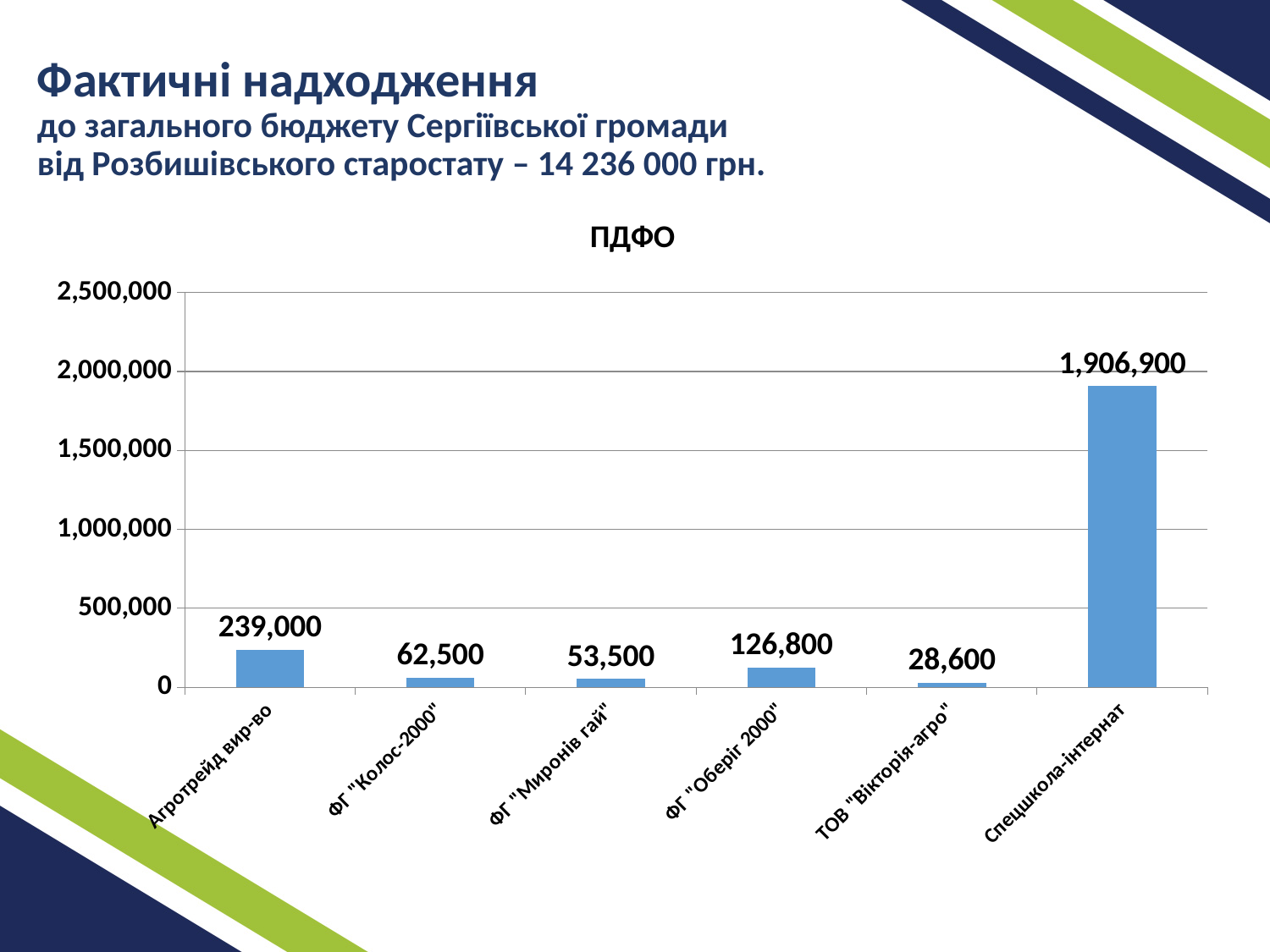
How many categories are shown on the chart? 6 Is the value for Спецшкола-інтернат greater or less than 1,500,000? greater What kind of chart is shown on the slide? bar chart What is the value for Спецшкола-інтернат? 1,906,900 Which is larger, the value for Агротрейд вир-во or the value for ФГ "Оберіг 2000"? Агротрейд вир-во What is the value for ТОВ "Вікторія-агро"? 28,600 Which category has the highest value? Спецшкола-інтернат What is the value for ФГ "Оберіг 2000"? 126,800 What is the value for Агротрейд вир-во? 239,000 What is the difference between the values for ФГ "Колос-2000" and ФГ "Миронів гай"? 9,000 What is the title of the chart? ПДФО Which category has the lowest value? ТОВ "Вікторія-агро"